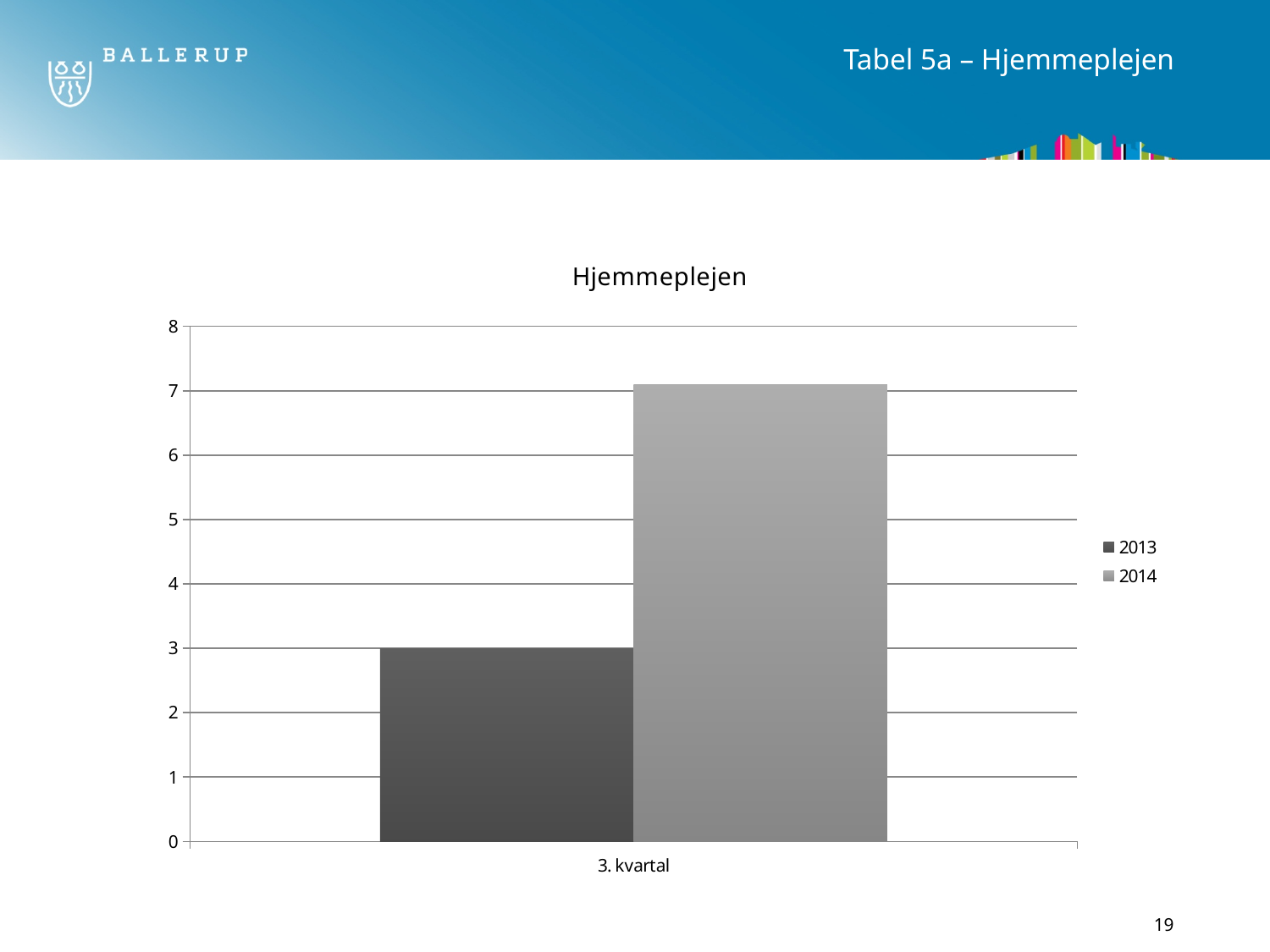
What kind of chart is shown on the slide? bar chart Which series has the highest value in the chart? 2014 What is the title of the chart? Hjemmeplejen Which series has the lowest value in the chart? 2013 What is the value for 2013 in 3. kvartal? 3 Is the value for 2013 in 3. kvartal greater or less than 4? less Which series has the higher value for 3. kvartal, 2013 or 2014? 2014 Is the value for 2014 in 3. kvartal greater or less than 6? greater What is the label of the category on the x axis? 3. kvartal How many series does the legend list? 2 How many categories are shown on the x axis? 1